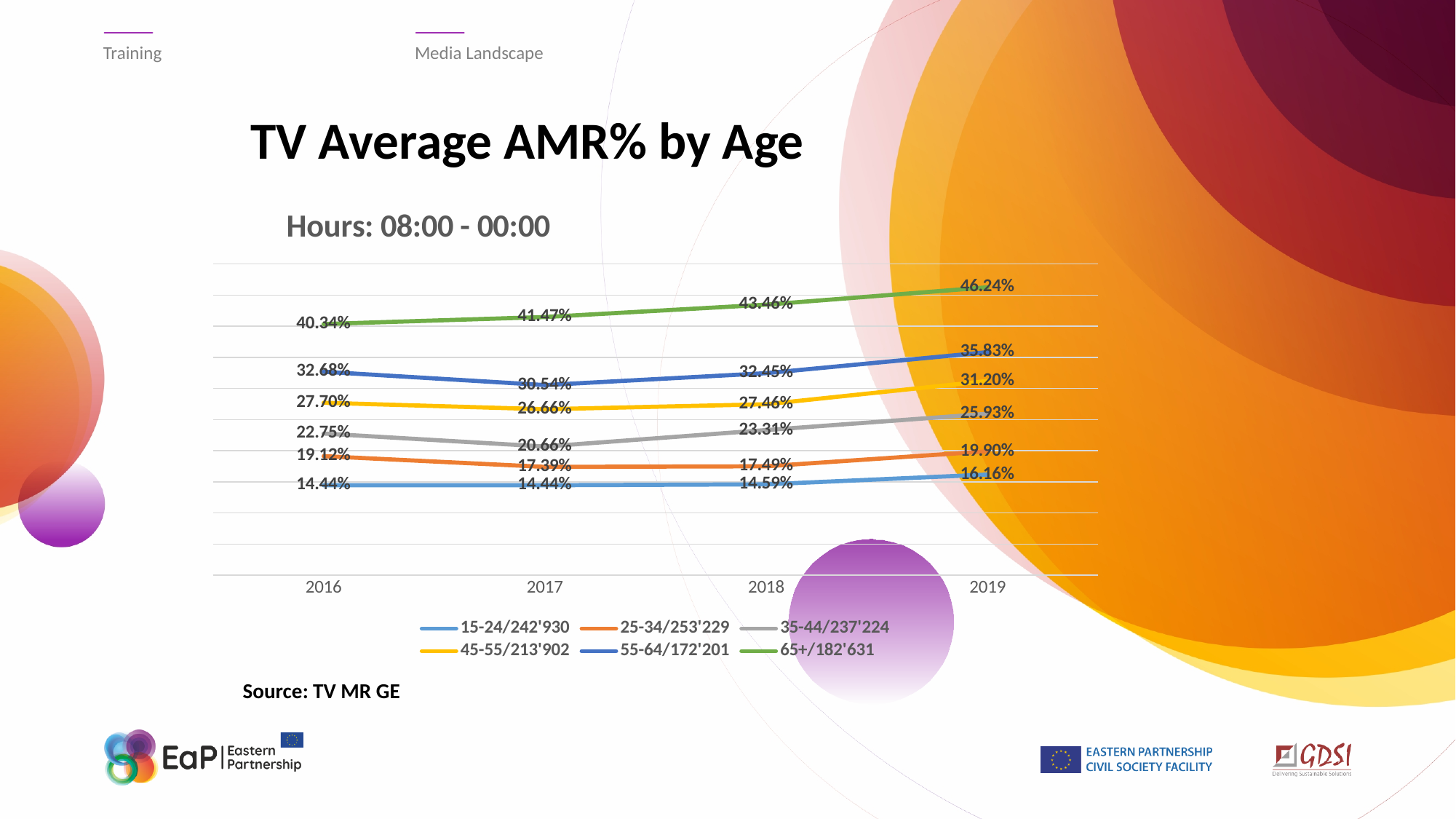
Which is larger in 2017: the 55-64/172'201 value or the 45-55/213'902 value? 55-64/172'201 What is the value for the 65+/182'631 series in 2019? 46.24% How many series does the legend list? 6 What is the difference between the 65+/182'631 value in 2019 and in 2016? 5.90% Which series has the highest value in 2019? 65+/182'631 What is the value for the 35-44/237'224 series in 2018? 23.31% How many years are shown on the x axis? 4 Does the 65+/182'631 series rise or fall from 2016 to 2019? rise What is the value for the 15-24/242'930 series in 2017? 14.44% What kind of chart is shown on the slide? line chart What time range is stated in the chart subtitle? Hours: 08:00 - 00:00 Which series has the lowest value in 2016? 15-24/242'930